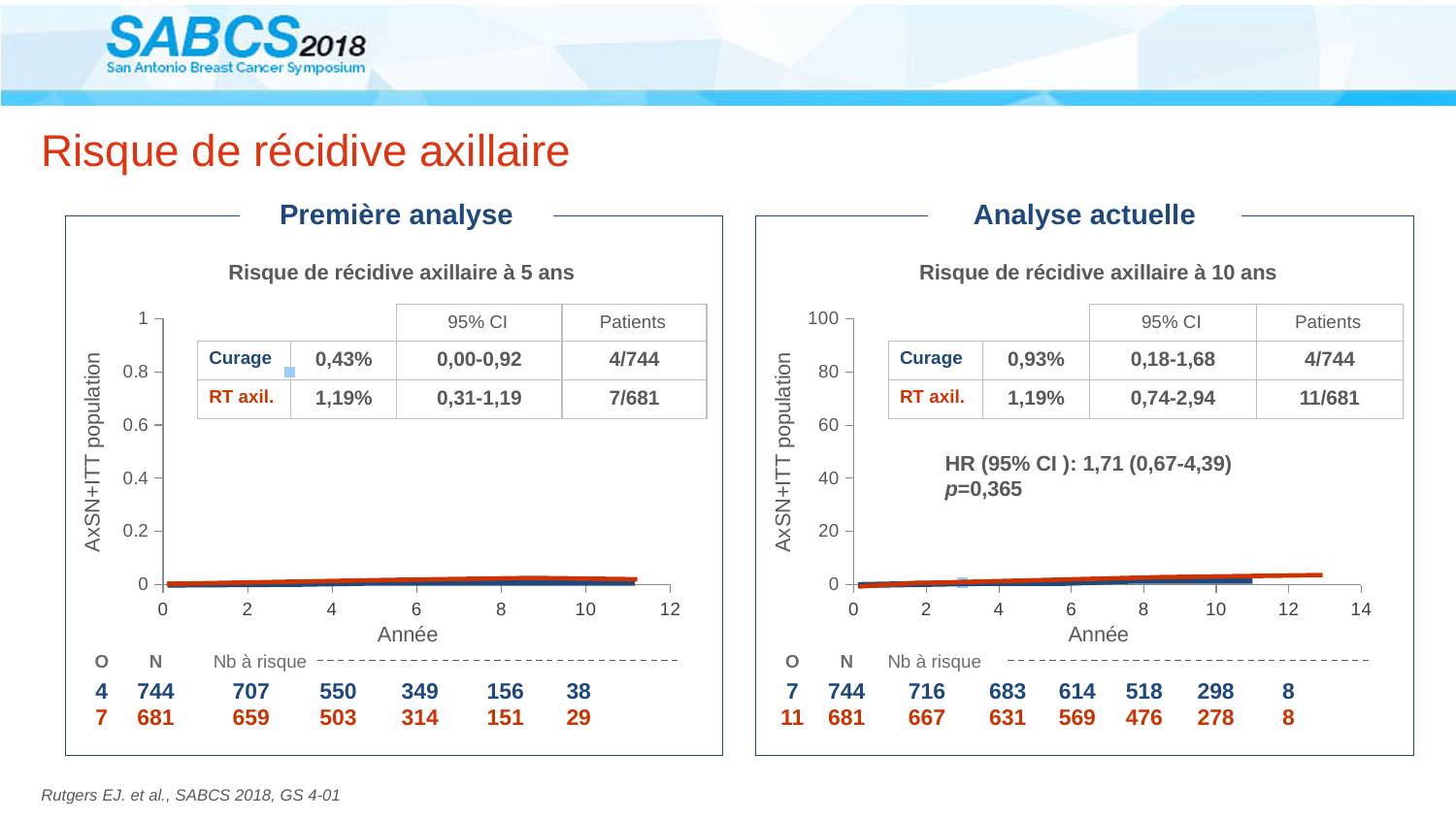
In the 'Analyse actuelle' chart, how many patients with events out of the total are reported for the RT axil. group? 11/681 In the 'Analyse actuelle' chart, what is the 10-year axillary recurrence risk for the RT axil. group? 1,19% In the 'Analyse actuelle' chart, what is the p-value shown? 0,365 In the 'Analyse actuelle' chart, what is the hazard ratio with its 95% CI? 1,71 (0,67-4,39) In the 'Première analyse' chart, how many patients with events out of the total are reported for the Curage group? 4/744 In the 'Analyse actuelle' chart, what is the 10-year axillary recurrence risk for the Curage group? 0,93% In the 'Première analyse' chart, what is the 5-year axillary recurrence risk for the Curage group? 0,43% In the 'Analyse actuelle' chart, what is the 95% CI for the RT axil. group? 0,74-2,94 In the 'Analyse actuelle' chart, which group has the higher 10-year axillary recurrence risk, Curage or RT axil.? RT axil. In the 'Première analyse' chart, what is the 5-year axillary recurrence risk for the RT axil. group? 1,19% What kind of chart is used in the 'Première analyse' panel? Line chart In the 'Première analyse' chart, what is the number at risk for the Curage group at year 10? 38